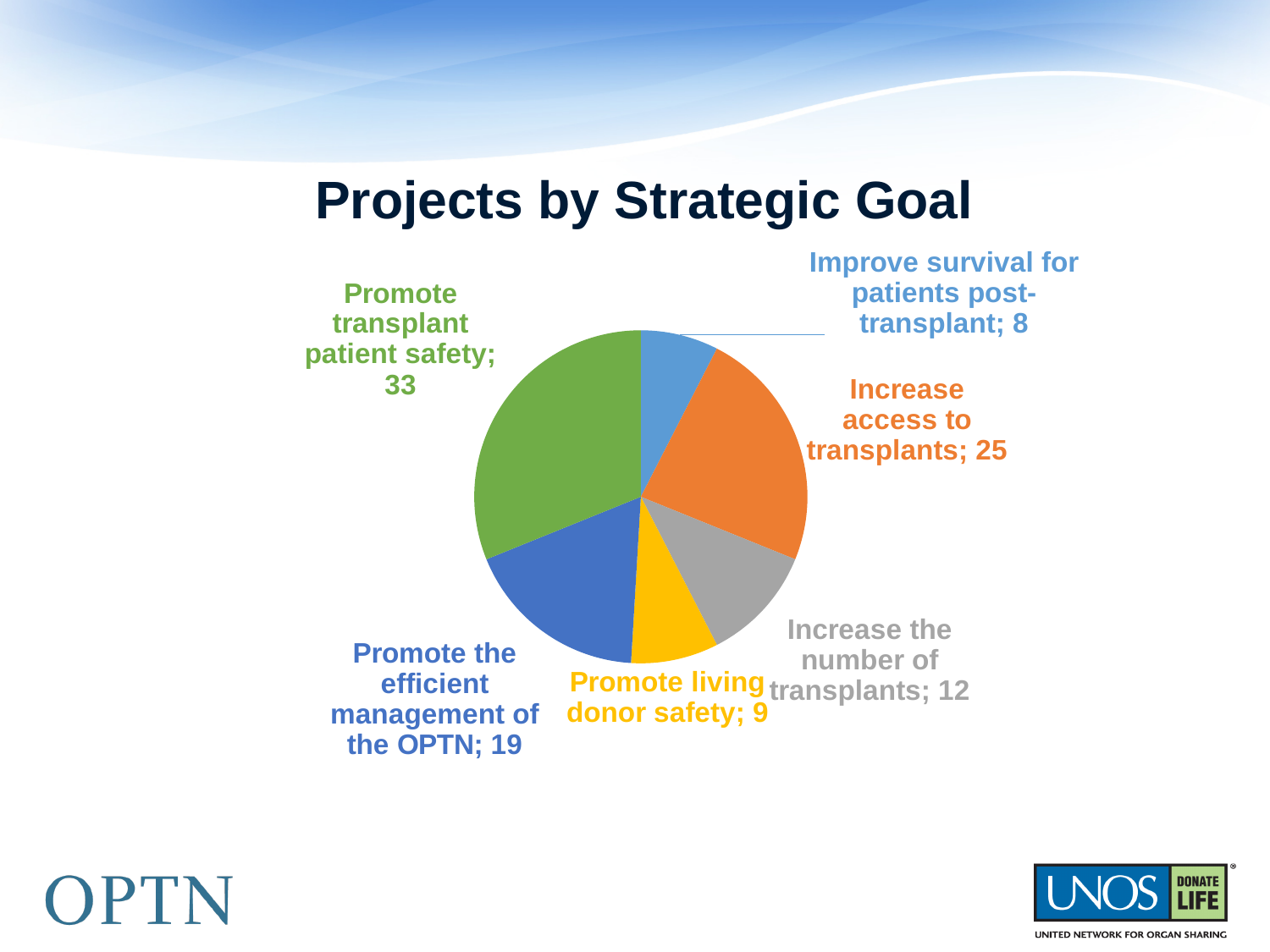
How many strategic goal categories are shown in the pie chart? 6 What type of chart is shown on the slide? Pie chart What is the title of the chart? Projects by Strategic Goal Which strategic goal has the most projects? Promote transplant patient safety Which has more projects: 'Increase the number of transplants' or 'Promote living donor safety'? Increase the number of transplants How many projects are in the 'Improve survival for patients post-transplant' category? 8 What is the total number of projects across all strategic goals shown? 106 Which strategic goal has the fewest projects? Improve survival for patients post-transplant How many projects are in the 'Promote living donor safety' category? 9 How many more projects does 'Promote transplant patient safety' have than 'Promote the efficient management of the OPTN'? 14 How many projects are in the 'Promote transplant patient safety' category? 33 How many projects are in the 'Increase access to transplants' category? 25